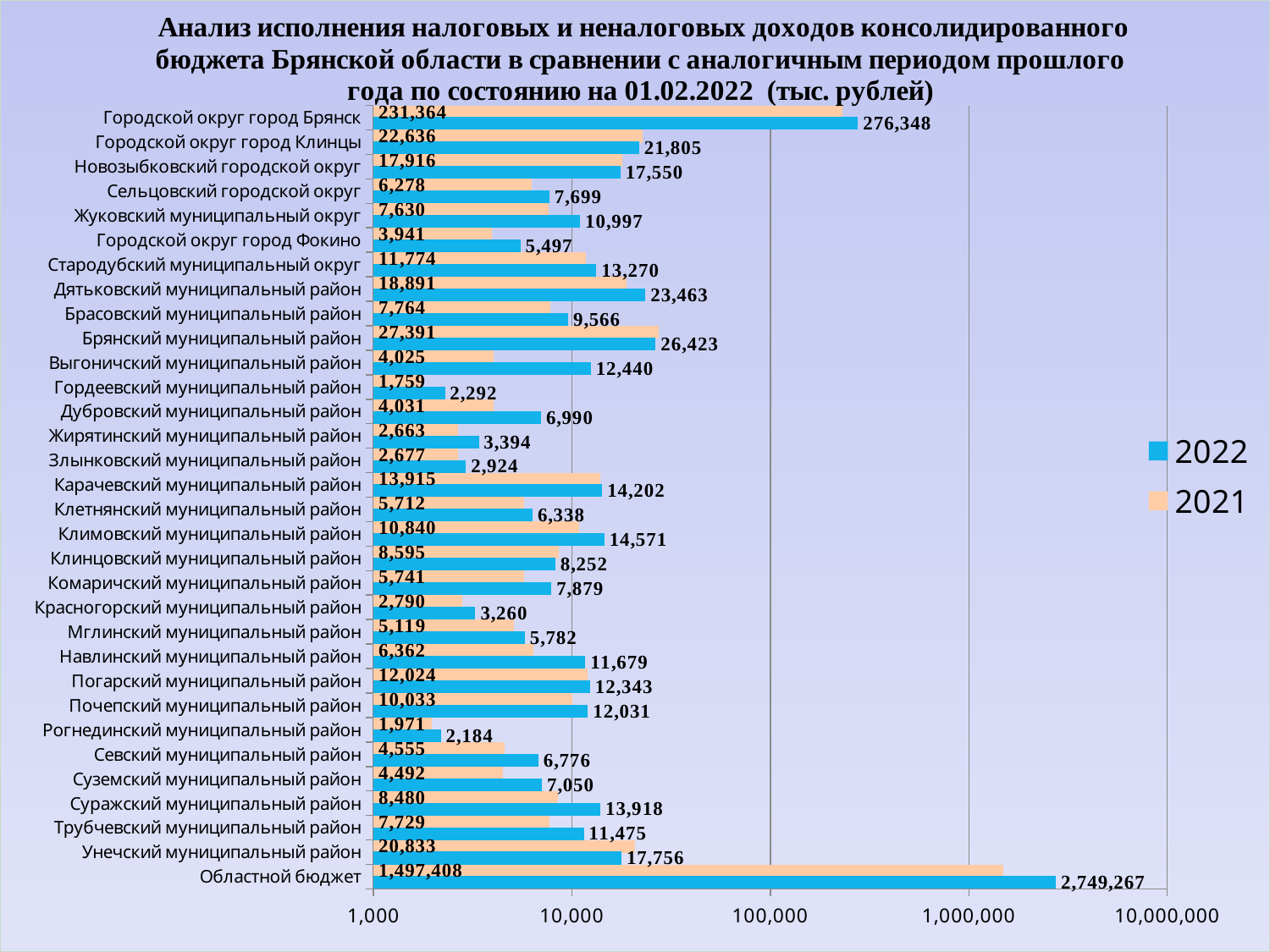
Which category has the lowest 2021 value? Гордеевский муниципальный район What is the difference between the 2022 and 2021 values for Городской округ город Брянск? 44,984 What is the 2021 value for Областной бюджет? 1,497,408 Which category has the highest 2022 value? Областной бюджет What type of chart is shown on the slide? bar chart What is the 2022 value for Выгоничский муниципальный район? 12,440 What is the difference between the 2022 and 2021 values for Областной бюджет? 1,251,859 How many categories are shown on the chart? 32 What is the 2021 value for Унечский муниципальный район? 20,833 For Унечский муниципальный район, which is larger: the 2021 value or the 2022 value? 2021 How many series does the legend list? 2 What is the 2022 value for Городской округ город Брянск? 276,348